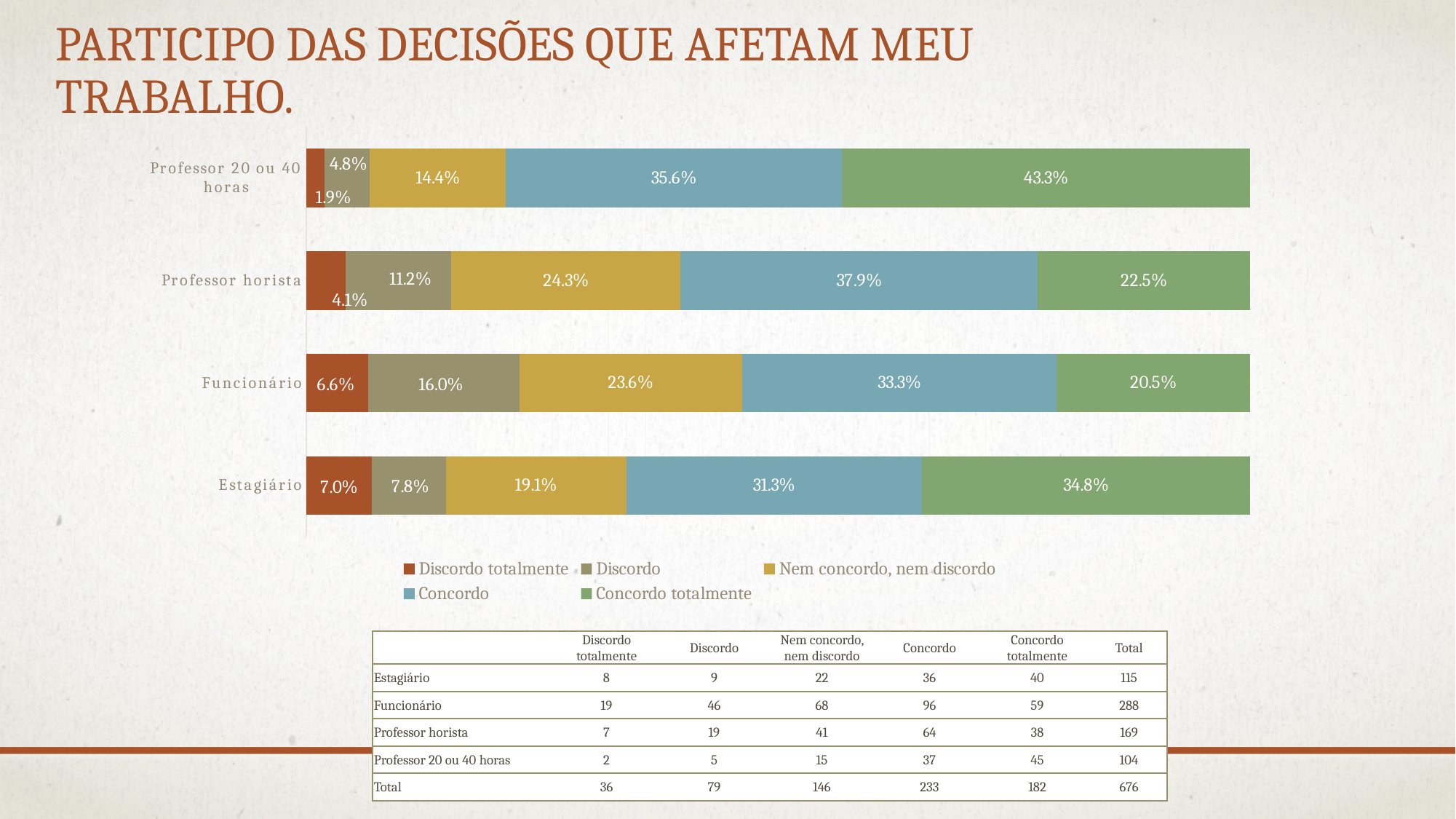
What is the 'Discordo totalmente' value for Estagiário? 7.0% What is the difference between the 'Concordo totalmente' values for Professor 20 ou 40 horas and Professor horista? 20.8 percentage points Which legend entry is shown in green? Concordo totalmente Which category has the highest 'Concordo totalmente' percentage? Professor 20 ou 40 horas Which has a larger 'Concordo' value, Professor horista or Funcionário? Professor horista What is the 'Nem concordo, nem discordo' value for Professor horista? 24.3% What is the 'Discordo' value for Funcionário? 16.0% How many categories (groups) are plotted in the chart? 4 What type of chart is shown on the slide? Stacked bar chart What is the 'Concordo totalmente' value for Professor 20 ou 40 horas? 43.3% Which category has the lowest 'Discordo totalmente' percentage? Professor 20 ou 40 horas How many series does the chart legend list? 5